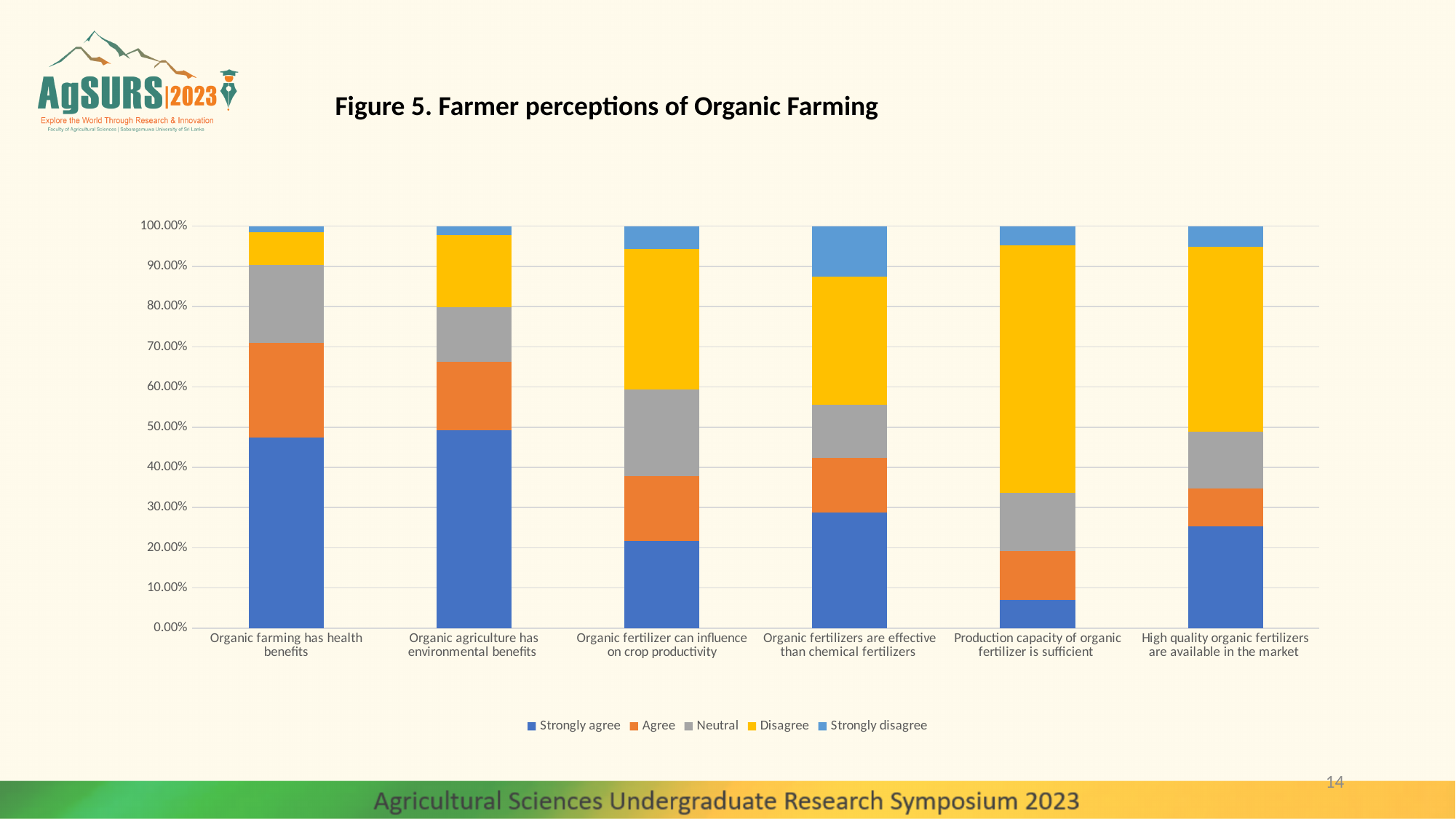
What kind of chart is shown on the slide? Stacked bar chart How many statements (categories) are shown on the x axis of the chart? 6 Which statement has the largest 'Disagree' share? Production capacity of organic fertilizer is sufficient Is the 'Strongly agree' share for 'Production capacity of organic fertilizer is sufficient' greater or less than 10.00%? less Which statement has a larger 'Strongly agree' share: 'Organic fertilizer can influence on crop productivity' or 'Organic fertilizers are effective than chemical fertilizers'? Organic fertilizers are effective than chemical fertilizers Which statement has a larger 'Strongly disagree' share: 'Organic farming has health benefits' or 'Organic fertilizers are effective than chemical fertilizers'? Organic fertilizers are effective than chemical fertilizers What is the title of the figure on the slide? Figure 5. Farmer perceptions of Organic Farming How many series does the chart's legend list? 5 Is the 'Strongly agree' share for 'Organic farming has health benefits' greater or less than 40.00%? greater Which colour represents the 'Disagree' series in the chart? Yellow Which statement has the smallest 'Strongly agree' share? Production capacity of organic fertilizer is sufficient Which statement has the largest 'Strongly disagree' share? Organic fertilizers are effective than chemical fertilizers